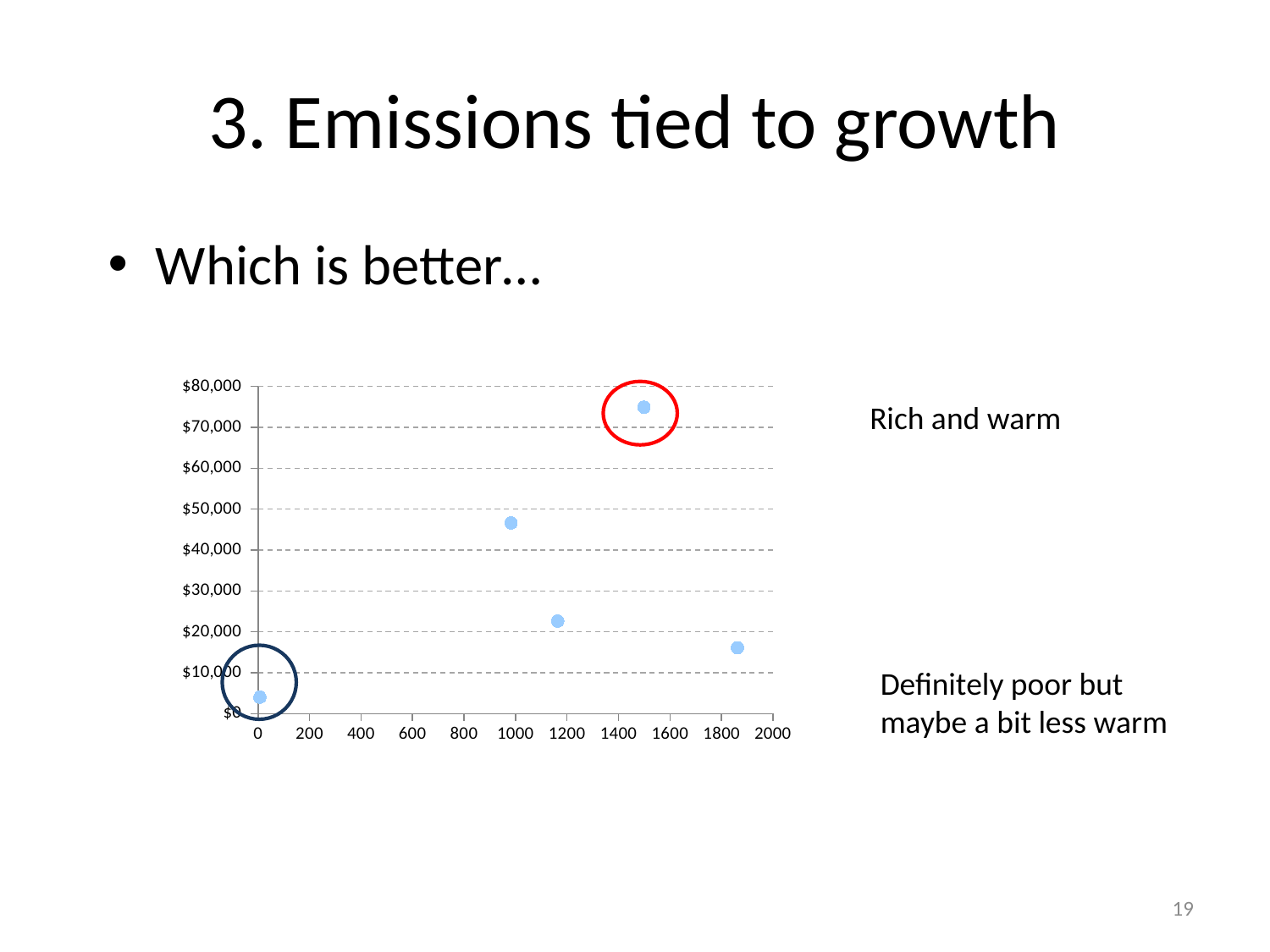
How many data points are plotted on the chart? 5 What is the highest value shown on the vertical axis? $80,000 Which point has the highest value on the vertical axis? the point circled in red (near x = 1500) What kind of chart is shown on the slide? scatter chart Which has the higher vertical-axis value: the point near x = 1000 or the point near x = 1200? the point near x = 1000 What label is placed next to the point circled in red? Rich and warm Which point has the lowest value on the vertical axis? the point circled in dark blue (at x = 0) Is the value of the point circled in red greater or less than $70,000? greater Is the value of the point circled in dark blue (at x = 0) greater or less than $10,000? less Is the value of the point near x = 1900 greater or less than $20,000? less